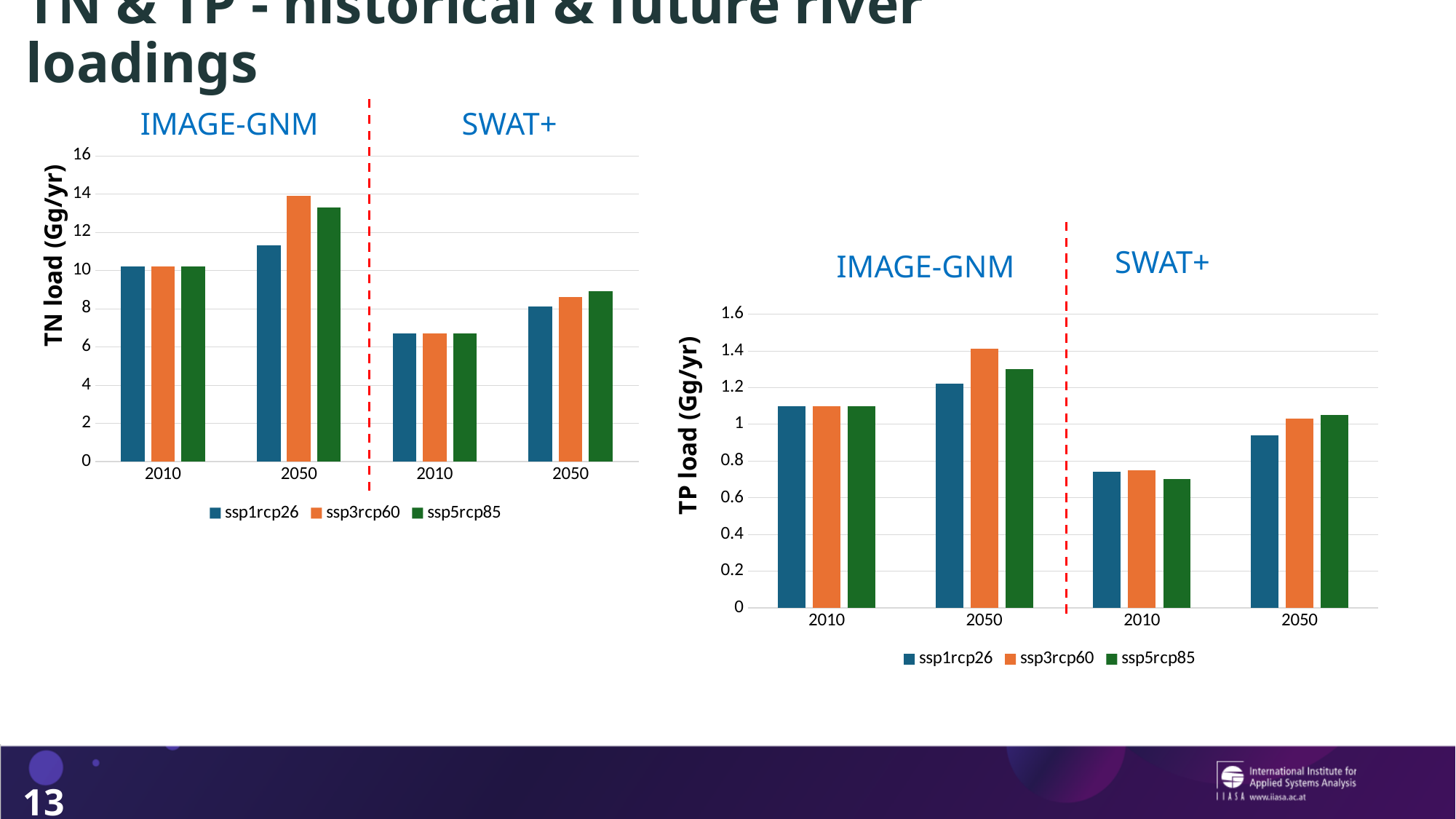
In the left chart (TN load), is the value for ssp1rcp26 in 2010 under SWAT+ greater or less than 8? less In the left chart (TN load), how many series does the legend list? 3 In the right chart (TP load), which scenario has the highest TP load in 2050 under IMAGE-GNM? ssp3rcp60 What kind of chart is the left chart showing TN load? bar chart What is the y-axis label of the right chart? TP load (Gg/yr) In the right chart (TP load), is the value for ssp3rcp60 in 2050 under IMAGE-GNM greater or less than 1.2? greater In the right chart (TP load), which scenario has the lowest TP load in 2010 under SWAT+? ssp5rcp85 In the left chart (TN load), which is larger for ssp1rcp26 in 2010: the IMAGE-GNM value or the SWAT+ value? IMAGE-GNM In the left chart (TN load), how many year groups of bars are plotted along the x axis? 4 In the left chart (TN load), which scenario has the highest TN load in 2050 under IMAGE-GNM? ssp3rcp60 In the right chart (TP load), is the value for ssp5rcp85 in 2010 under SWAT+ greater or less than 0.8? less